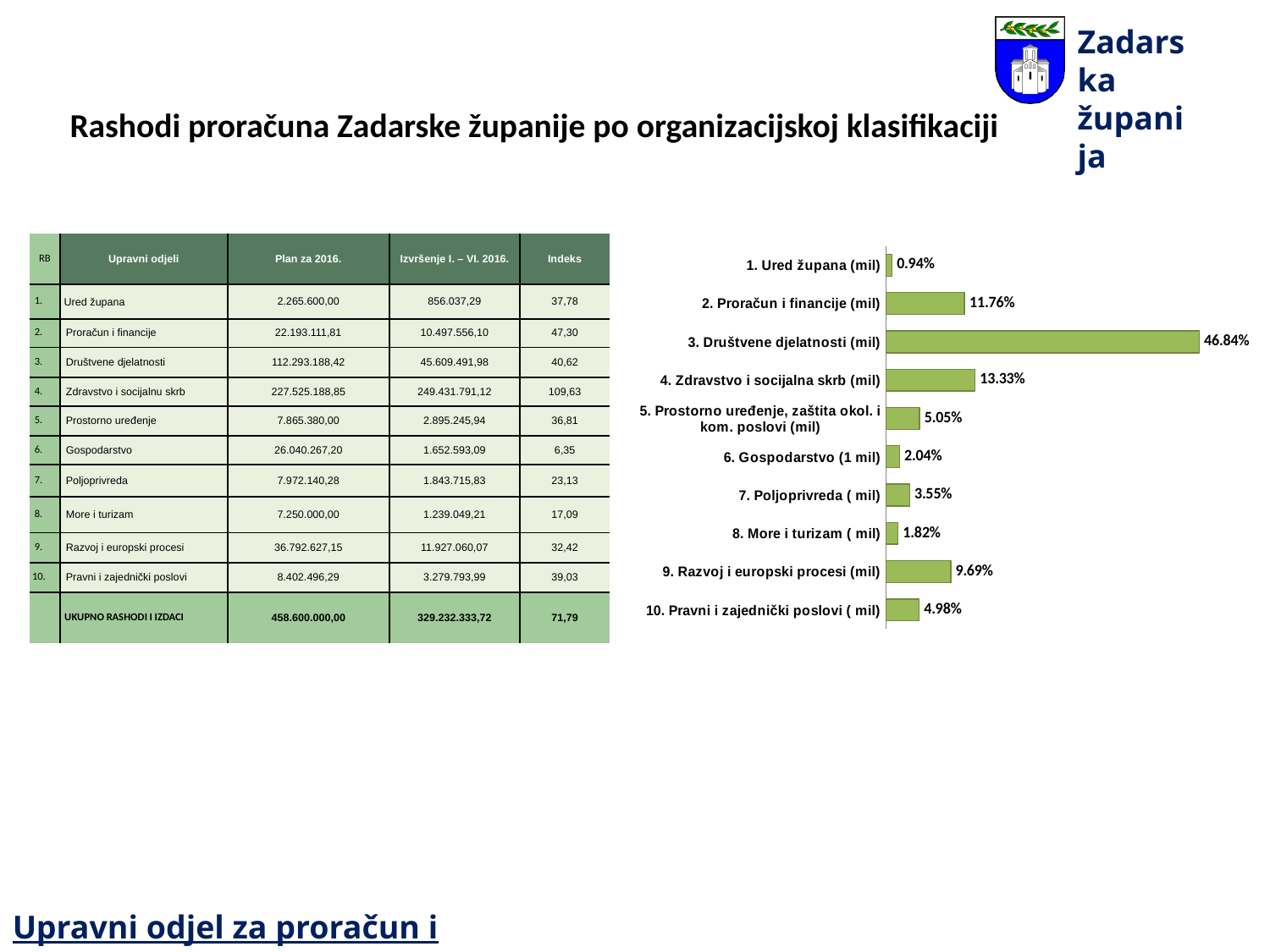
Which is larger in the bar chart: the value for "7. Poljoprivreda ( mil)" or "6. Gospodarstvo (1 mil)"? 7. Poljoprivreda ( mil) Which category has the highest value in the bar chart? 3. Društvene djelatnosti (mil) What is the value for "3. Društvene djelatnosti (mil)" in the bar chart? 46.84% What is the value for "9. Razvoj i europski procesi (mil)" in the bar chart? 9.69% Which category has the lowest value in the bar chart? 1. Ured župana (mil) What is the difference between the values for "9. Razvoj i europski procesi (mil)" and "8. More i turizam ( mil)" in the bar chart? 7.87% What is the value for "4. Zdravstvo i socijalna skrb (mil)" in the bar chart? 13.33% How many categories does the bar chart show? 10 Which is larger in the bar chart: the value for "5. Prostorno uređenje, zaštita okol. i kom. poslovi (mil)" or "10. Pravni i zajednički poslovi ( mil)"? 5. Prostorno uređenje, zaštita okol. i kom. poslovi (mil) What is the difference between the values for "4. Zdravstvo i socijalna skrb (mil)" and "2. Proračun i financije (mil)" in the bar chart? 1.57% What kind of chart is shown on the slide? bar chart What is the value for "1. Ured župana (mil)" in the bar chart? 0.94%